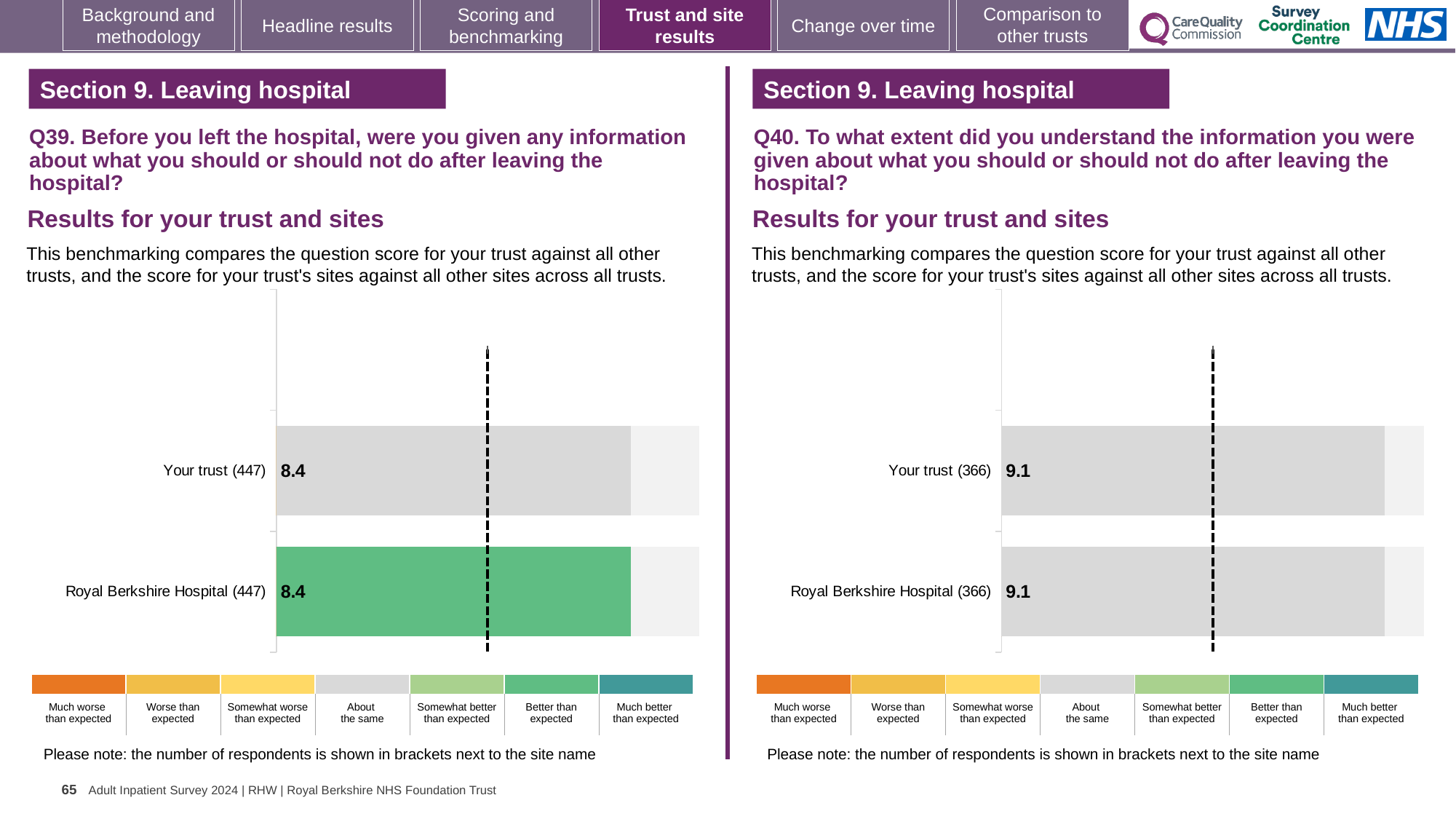
In the Q39 chart on the left, which benchmark category does the green colour of the Royal Berkshire Hospital bar correspond to? Better than expected In the Q39 chart on the left, what is the score for Royal Berkshire Hospital? 8.4 In the Q39 chart on the left, what is the difference between the score for Your trust and the score for Royal Berkshire Hospital? 0 In the Q40 chart on the right, which benchmark category does the grey colour of the Royal Berkshire Hospital bar correspond to? About the same In the Q40 chart on the right, what is the score for Your trust? 9.1 In the Q40 chart on the right, what is the score for Royal Berkshire Hospital? 9.1 What kind of chart is the Q39 chart on the left? Bar chart In the Q39 chart on the left, how many respondents are shown in brackets for Royal Berkshire Hospital? 447 In the Q40 chart on the right, how many respondents are shown in brackets for Your trust? 366 How many benchmark categories does the colour key below the Q39 chart on the left list? 7 In the Q39 chart on the left, what is the score for Your trust? 8.4 How many bars are plotted in the Q40 chart on the right? 2